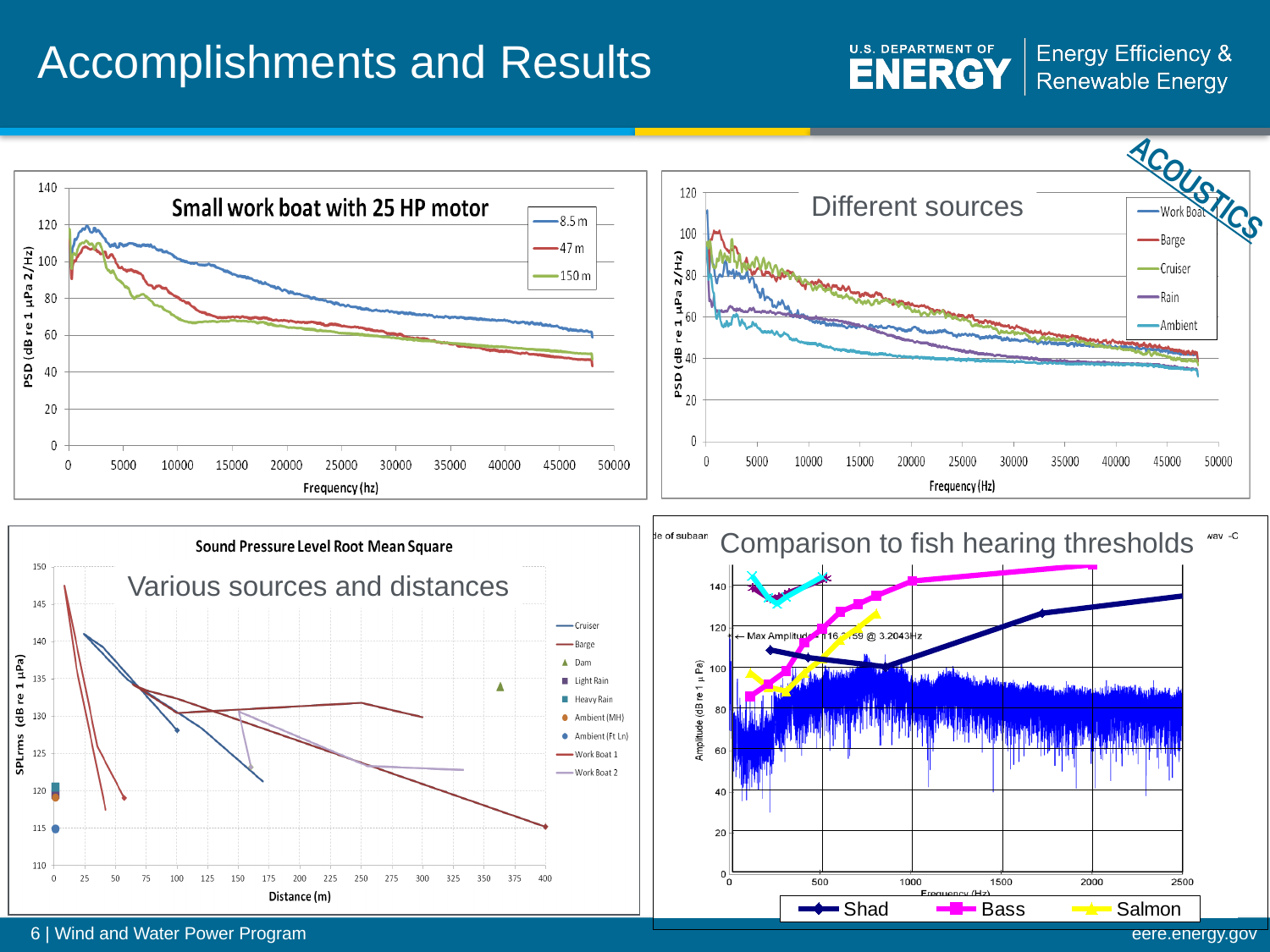
In the 'Comparison to fish hearing thresholds' chart, which is larger at 2000 Hz, Bass or Shad? Bass In the 'Small work boat with 25 HP motor' chart, does the 8.5 m series rise or fall as frequency increases from 5000 to 45000 Hz? fall In the 'Different sources' chart, which series is lowest at 10000 Hz? Ambient In the 'Different sources' chart, which is larger at 10000 Hz, Barge or Ambient? Barge What kind of chart is the 'Small work boat with 25 HP motor' chart? line chart How many entries does the legend of the 'Sound Pressure Level Root Mean Square' chart list? 9 In the 'Small work boat with 25 HP motor' chart, is the 8.5 m value at 5000 Hz greater or less than 100? greater What is the x-axis label of the 'Sound Pressure Level Root Mean Square' chart? Distance (m) How many series does the legend of the 'Different sources' chart list? 5 In the 'Comparison to fish hearing thresholds' chart, is the Bass value at 2000 Hz greater or less than 140? greater In the 'Different sources' chart, is the Ambient value at 40000 Hz greater or less than 60? less How many series does the legend of the 'Small work boat with 25 HP motor' chart list? 3